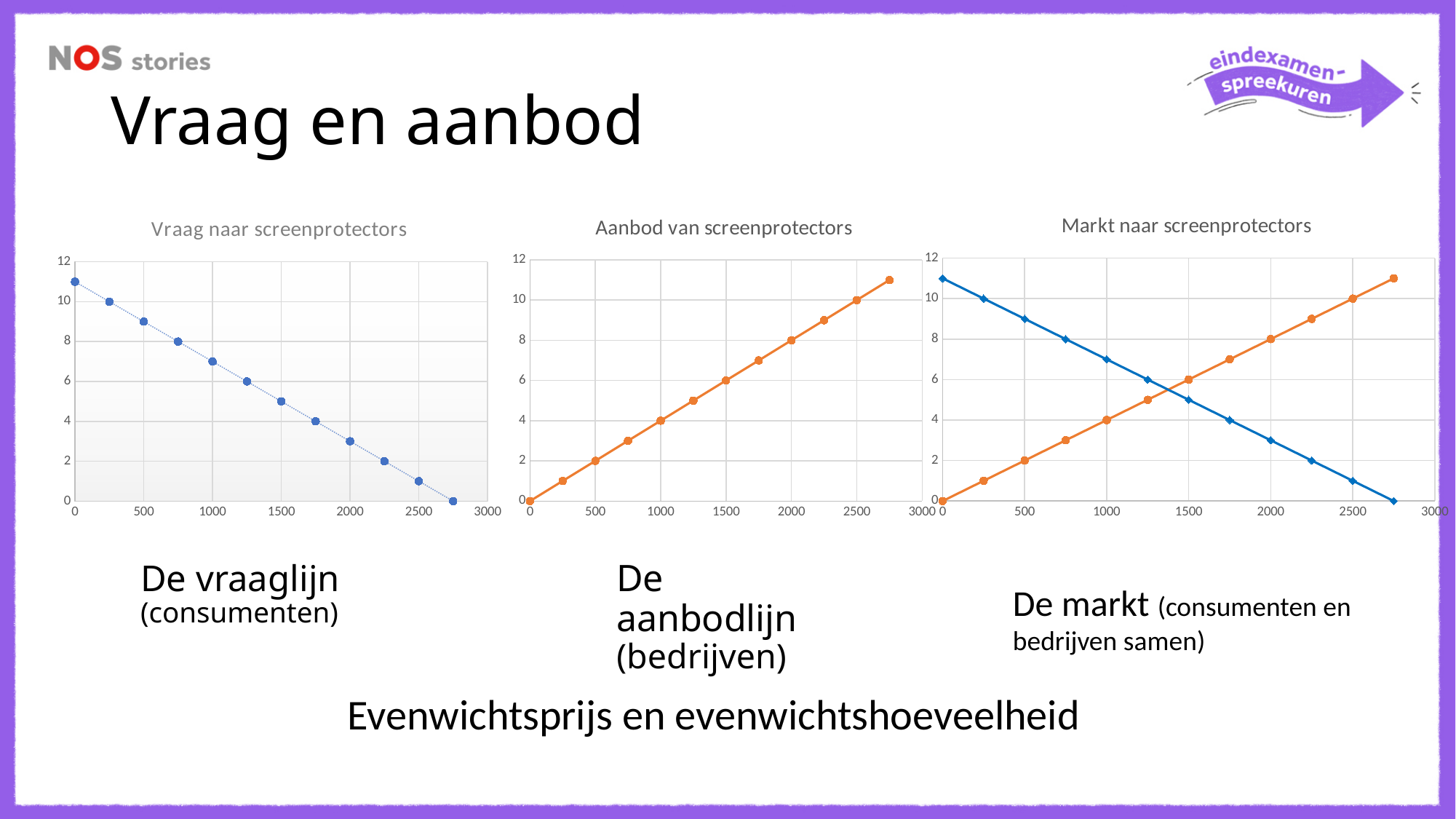
What kind of chart is the 'Vraag naar screenprotectors' chart? line chart In the 'Vraag naar screenprotectors' chart, is the value at x = 500 greater or less than 8? greater In the 'Aanbod van screenprotectors' chart, what is the value at x = 2000? 8 In the 'Aanbod van screenprotectors' chart, what is the value at x = 2500? 10 How many lines are plotted in the 'Markt naar screenprotectors' chart? 2 In the 'Vraag naar screenprotectors' chart, do the values rise or fall as the x axis increases? fall How many data points are plotted in the 'Aanbod van screenprotectors' chart? 12 In the 'Aanbod van screenprotectors' chart, do the values rise or fall as the x axis increases? rise What is the title of the leftmost chart on the slide? Vraag naar screenprotectors In the 'Markt naar screenprotectors' chart, at x = 2000, which line is higher, the blue line or the orange line? the orange line In the 'Aanbod van screenprotectors' chart, what is the value at x = 1000? 4 In the 'Vraag naar screenprotectors' chart, is the value at x = 1000 greater or less than 8? less